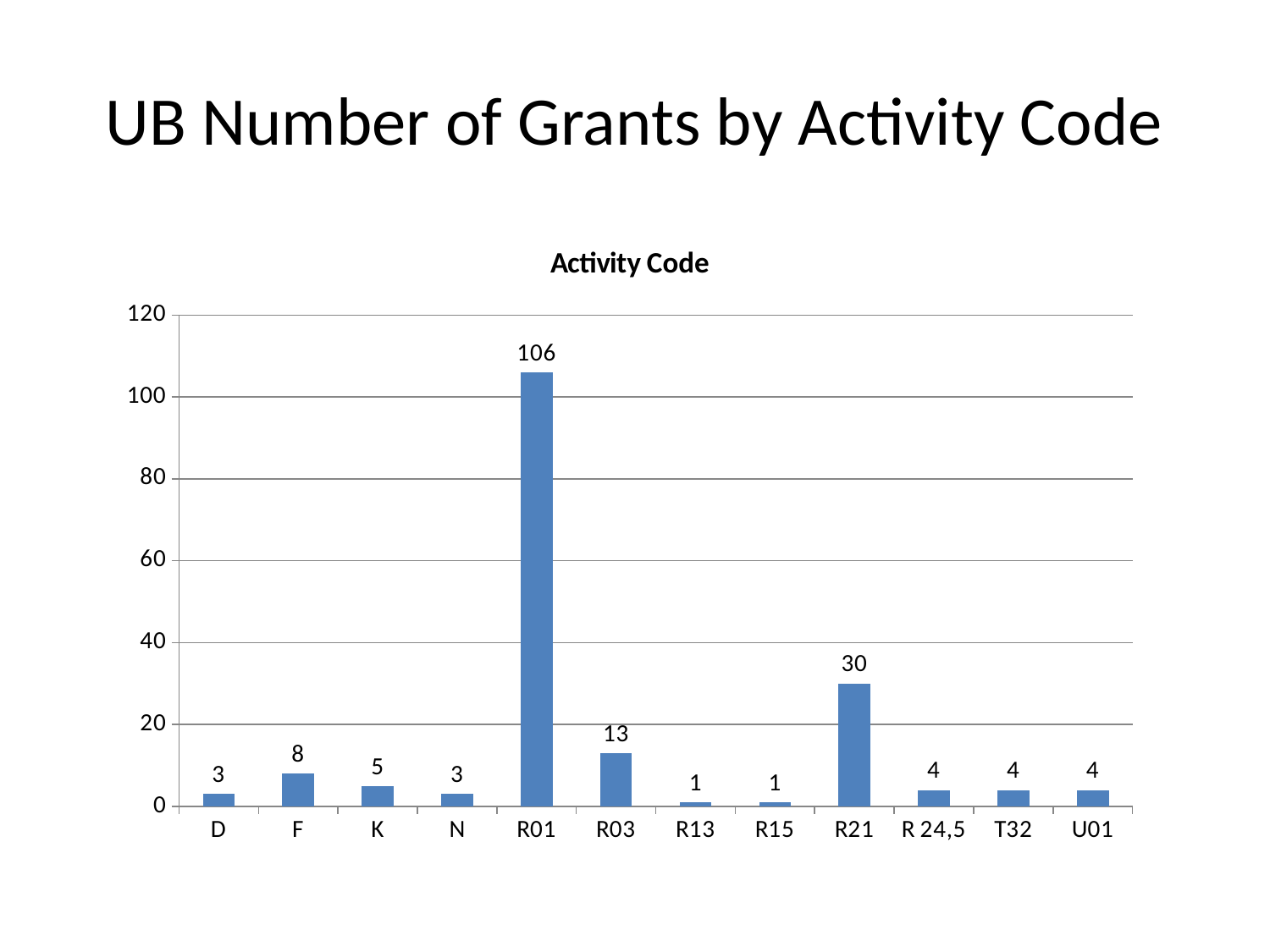
Which activity code has the highest number of grants? R01 What is the number of grants for activity code R03? 13 What is the number of grants for activity code R21? 30 What is the number of grants for activity code F? 8 What is the number of grants for activity code R01? 106 What is the difference in number of grants between K and N? 2 What is the title of the chart? Activity Code What is the difference in number of grants between R01 and R21? 76 Which has more grants, R03 or F? R03 Is the value for R21 greater or less than 40? less How many activity codes are shown on the x axis? 12 What kind of chart is shown on the slide? Bar chart